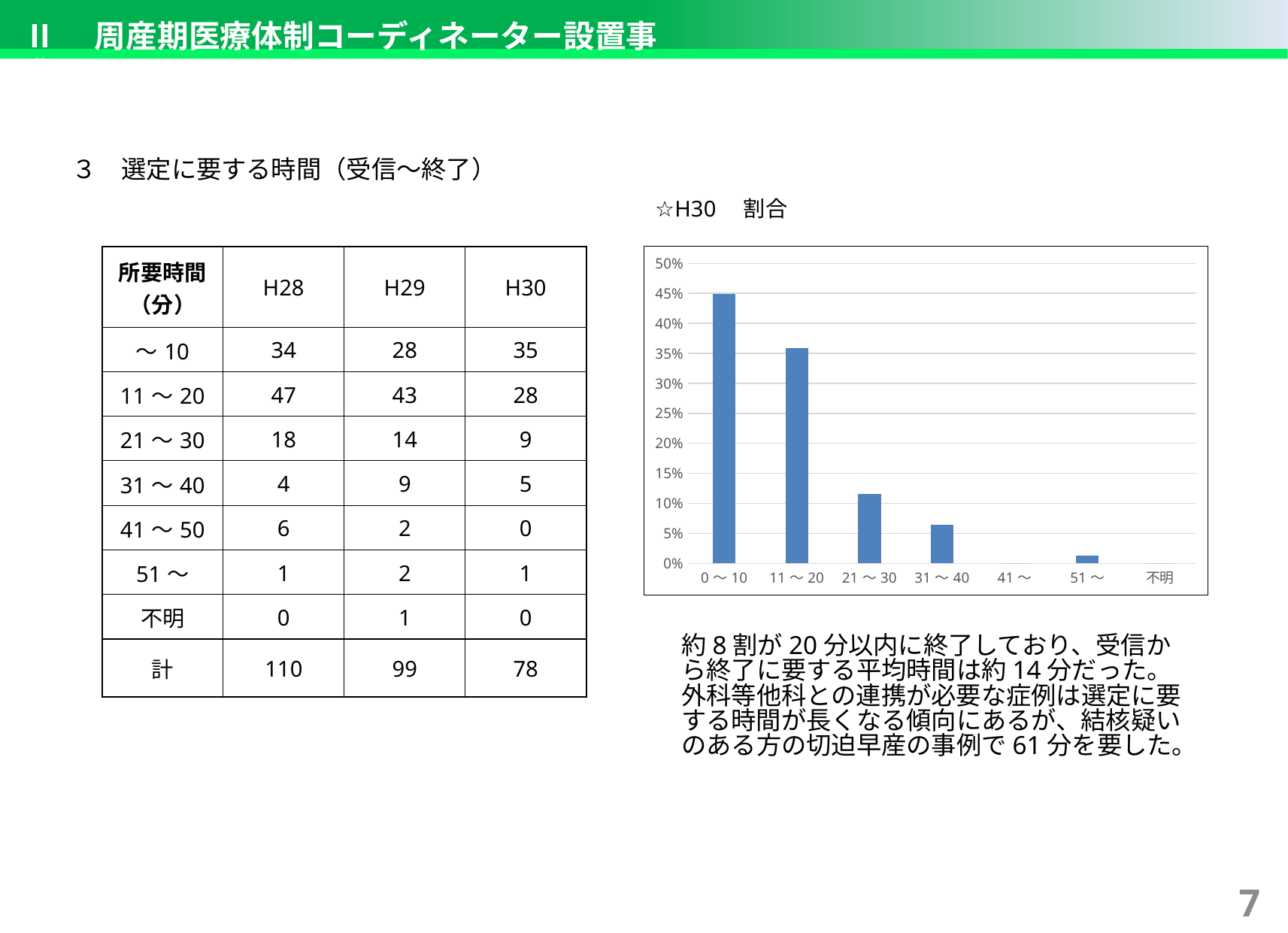
Is the value for 11 ～ 20 greater or less than 40%? less How many categories are shown on the x axis of the chart? 7 Is the value for 0 ～ 10 greater or less than 40%? greater Is the value for 21 ～ 30 greater or less than 15%? less Which category has the highest value in the chart? 0 ～ 10 What is the title shown above the chart? ☆H30 割合 Which is larger, the value for 0 ～ 10 or the value for 11 ～ 20? 0 ～ 10 What kind of chart is shown on the slide? bar chart Do the bar values generally rise or fall from left to right along the x axis? fall